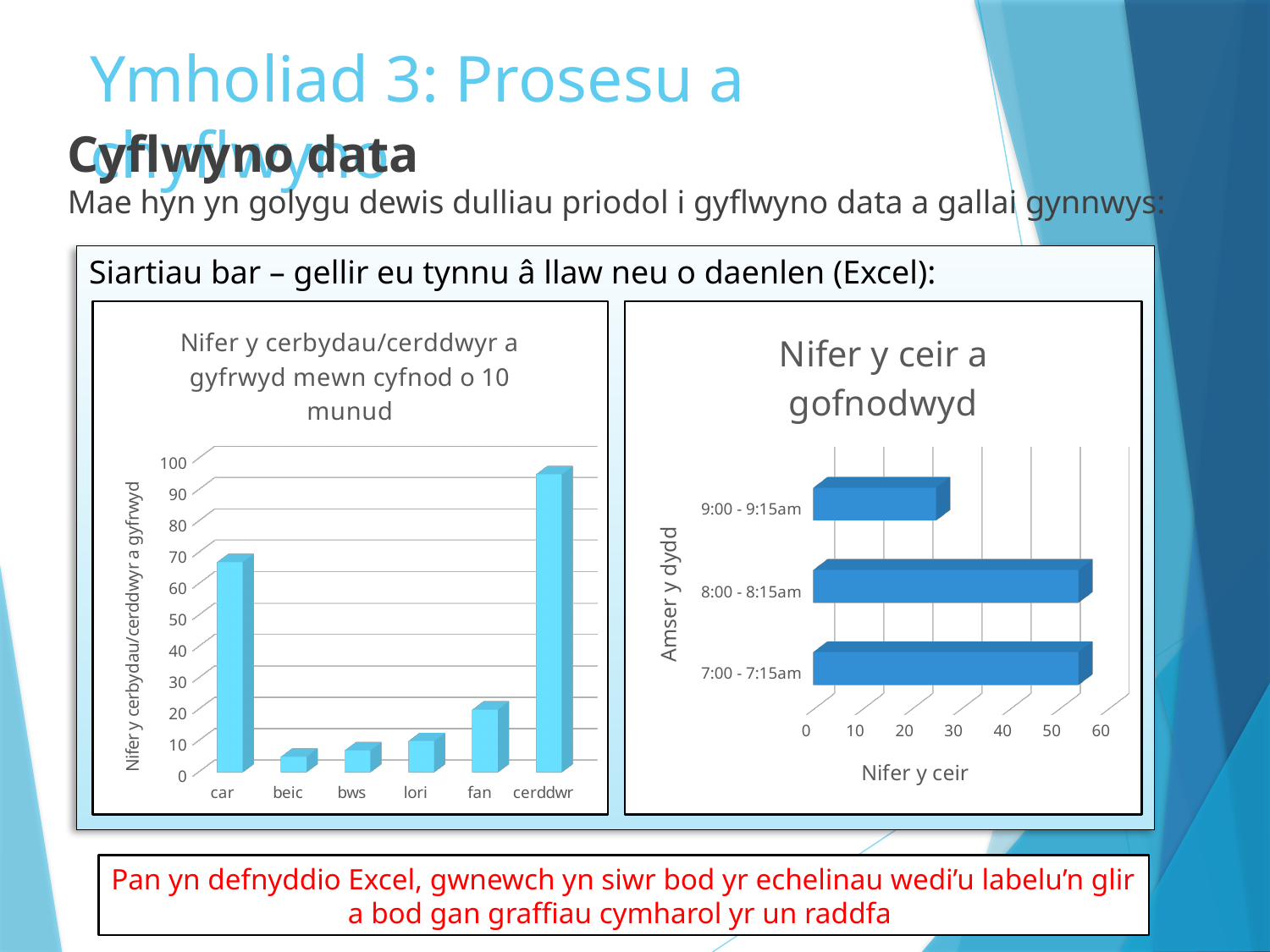
In the left chart, is the value for car greater or less than 60? greater In the right chart, is the value for 9:00 - 9:15am greater or less than 40? less In the right chart, which time period has the lowest number of cars? 9:00 - 9:15am In the left chart, which category has the highest value? cerddwr How many time periods are shown on the right chart? 3 What kind of chart is the left chart titled 'Nifer y cerbydau/cerddwyr a gyfrwyd mewn cyfnod o 10 munud'? Bar chart What is the x-axis title of the right chart? Nifer y ceir In the right chart, is the value for 8:00 - 8:15am greater or less than 50? greater In the left chart, which is larger, the value for car or the value for fan? car What kind of chart is the right chart titled 'Nifer y ceir a gofnodwyd'? Bar chart How many categories are shown on the x axis of the left chart? 6